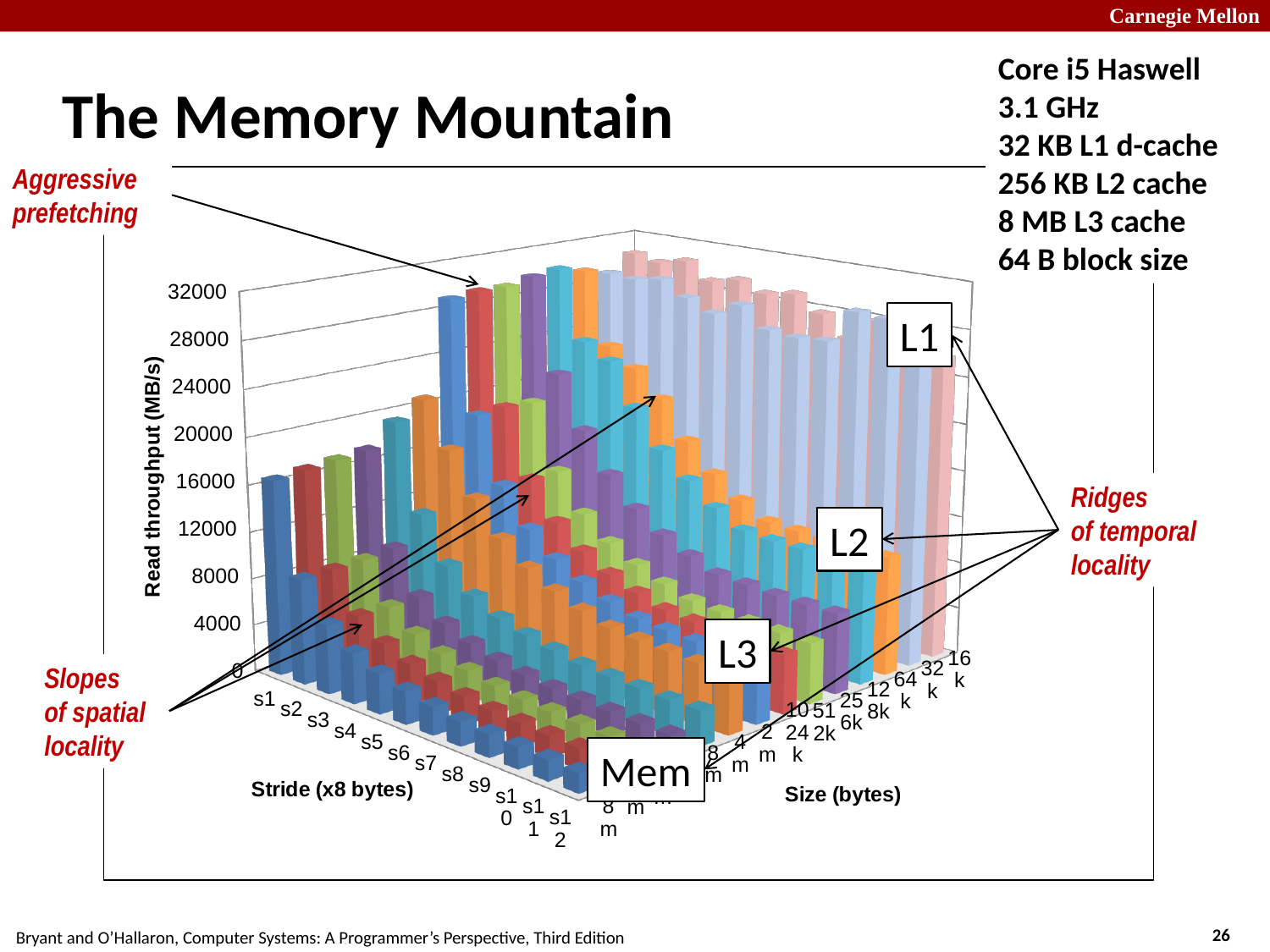
What is the highest tick value on the read throughput axis? 32000 What kind of chart is shown on the slide? 3D bar chart What is the label of the vertical axis? Read throughput (MB/s) For a fixed size, does read throughput generally rise or fall as the stride increases from s1 to s12? fall How many stride categories are shown along the stride axis? 12